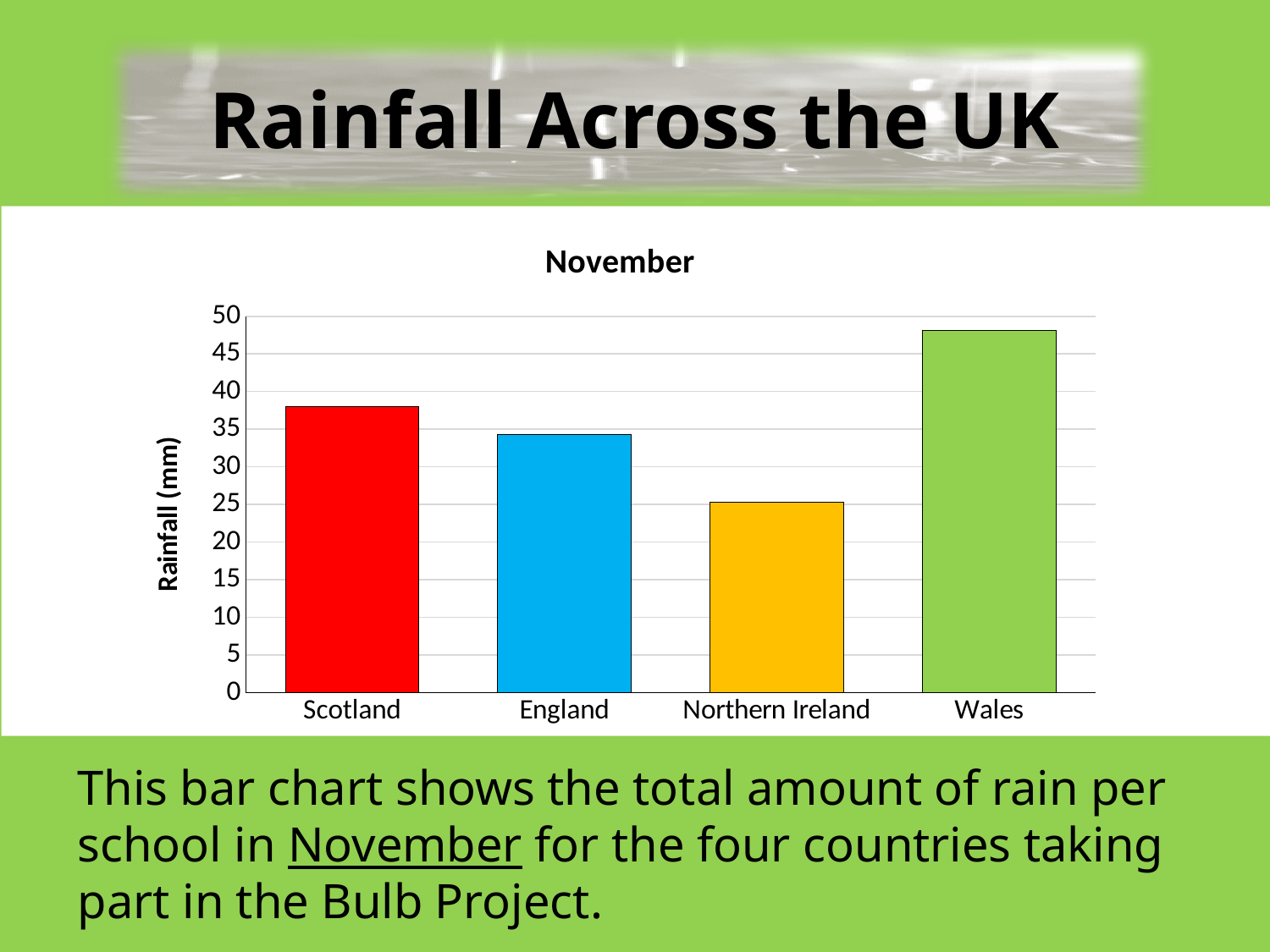
Which country has the lowest rainfall in the November chart? Northern Ireland What kind of chart is shown on the slide? bar chart Is the rainfall value for Scotland greater or less than 35? greater Which country has the highest rainfall in the November chart? Wales What is the label on the vertical axis of the chart? Rainfall (mm) Which has the higher rainfall, Scotland or England? Scotland Is the rainfall value for Northern Ireland greater or less than 30? less How many countries are shown on the x axis of the chart? 4 What is the title of the chart? November Is the rainfall value for Wales greater or less than 45? greater Which has the lower rainfall, England or Northern Ireland? Northern Ireland